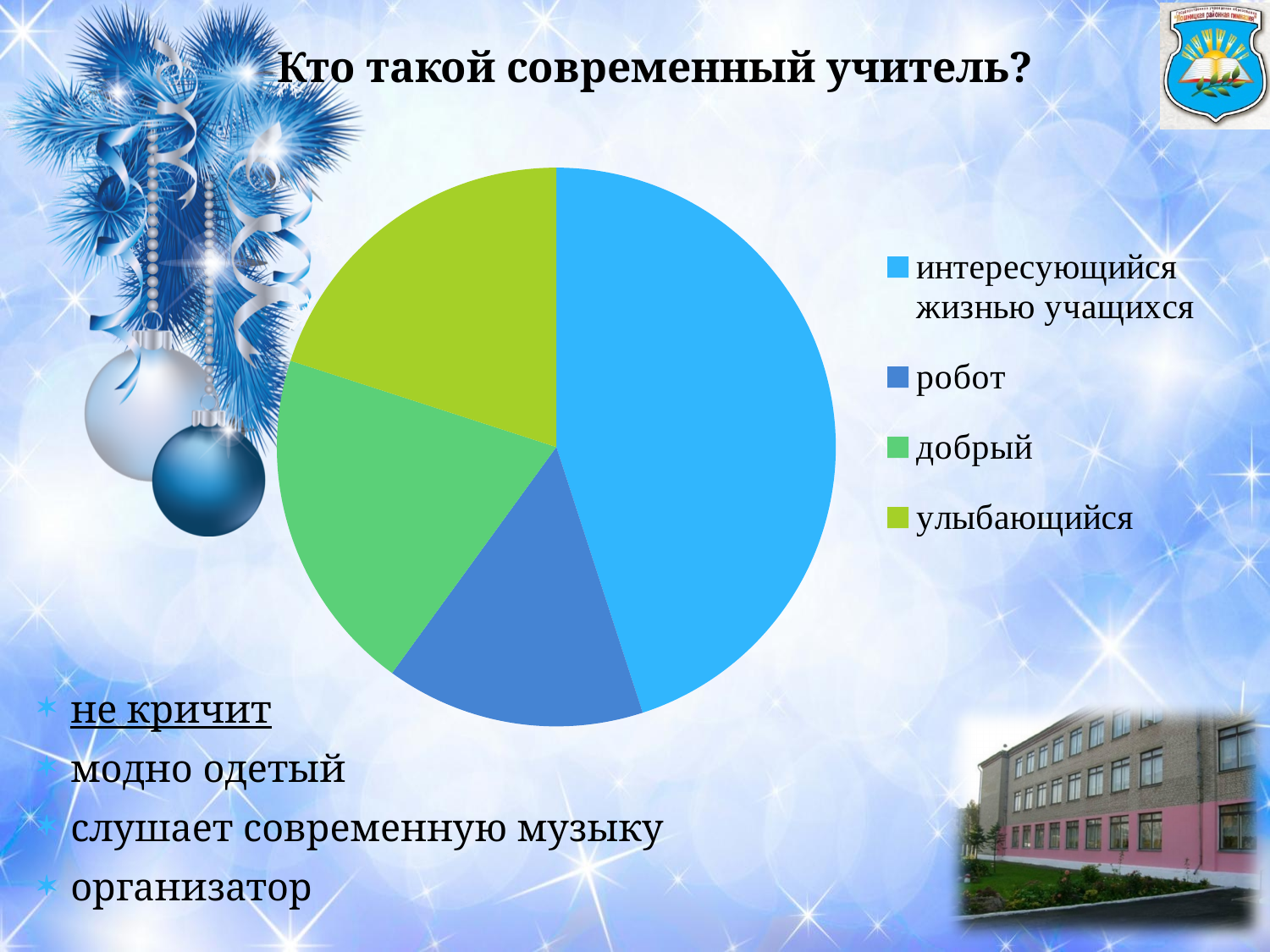
Which slice is larger: интересующийся жизнью учащихся or улыбающийся? интересующийся жизнью учащихся What kind of chart is shown on the slide? pie chart Which category is shown in light blue in the pie chart? интересующийся жизнью учащихся Which category has the smallest slice of the pie chart? робот How many slices does the pie chart have? 4 How many entries does the legend of the pie chart list? 4 Which slice is larger: робот or добрый? добрый Which category has the largest slice of the pie chart? интересующийся жизнью учащихся Which slice is larger: робот or улыбающийся? улыбающийся What is the title of the slide containing the pie chart? Кто такой современный учитель?